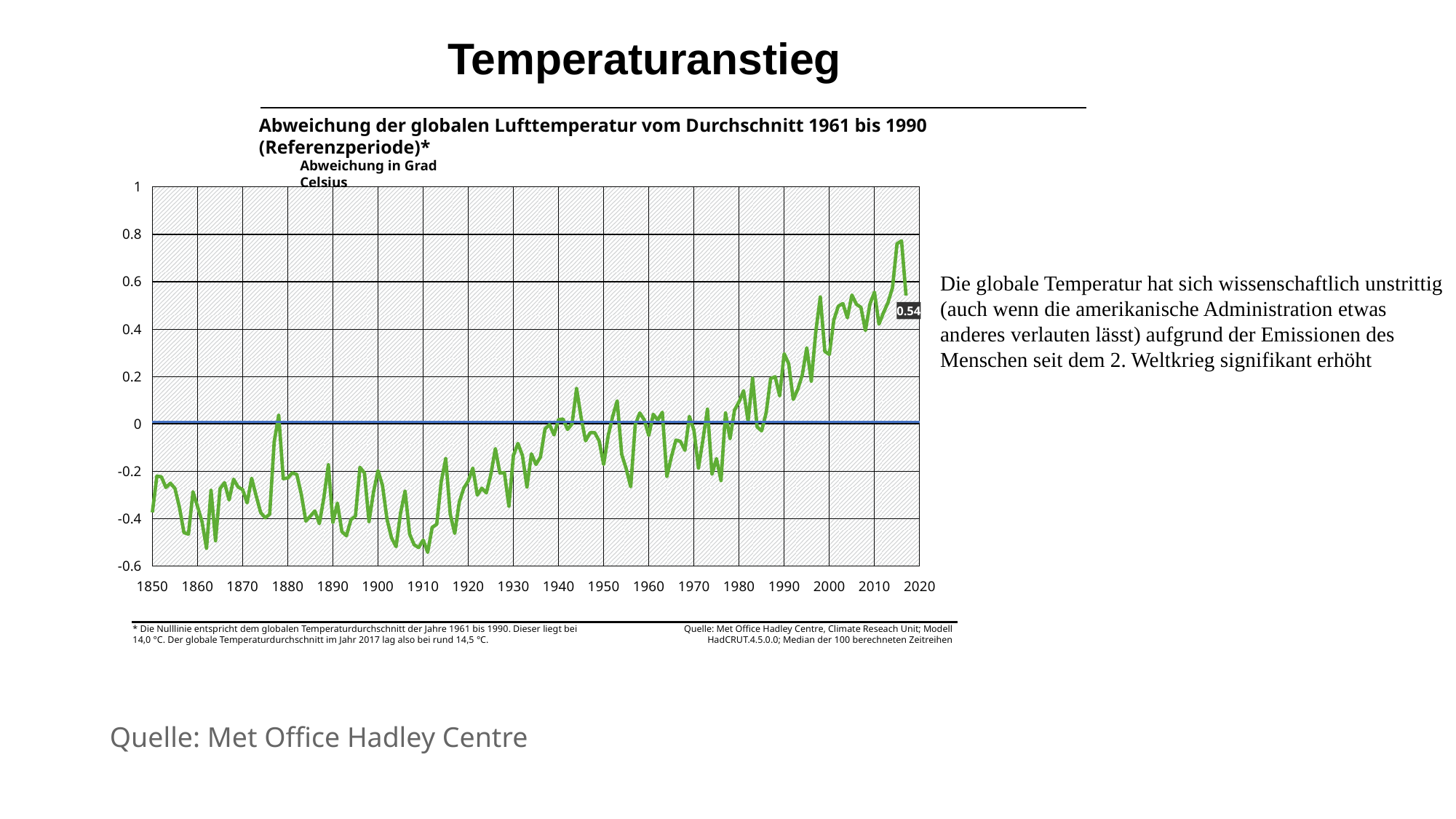
What kind of chart is shown on the slide? line chart What is the first year label on the x axis? 1850 Is the value for 2000 greater or less than 0.2? greater Is the value for 1910 greater or less than -0.4? less Which year has the larger value, 1850 or 2010? 2010 Is the value for 1850 greater or less than 0? less What is the title of the chart? Abweichung der globalen Lufttemperatur vom Durchschnitt 1961 bis 1990 (Referenzperiode)* What value is printed as the data label at the end of the line (the most recent year)? 0.54 Which year has the larger value, 1910 or 1940? 1940 What is the label of the y axis? Abweichung in Grad Celsius Overall, do the temperature deviation values rise or fall from 1850 to 2020? rise